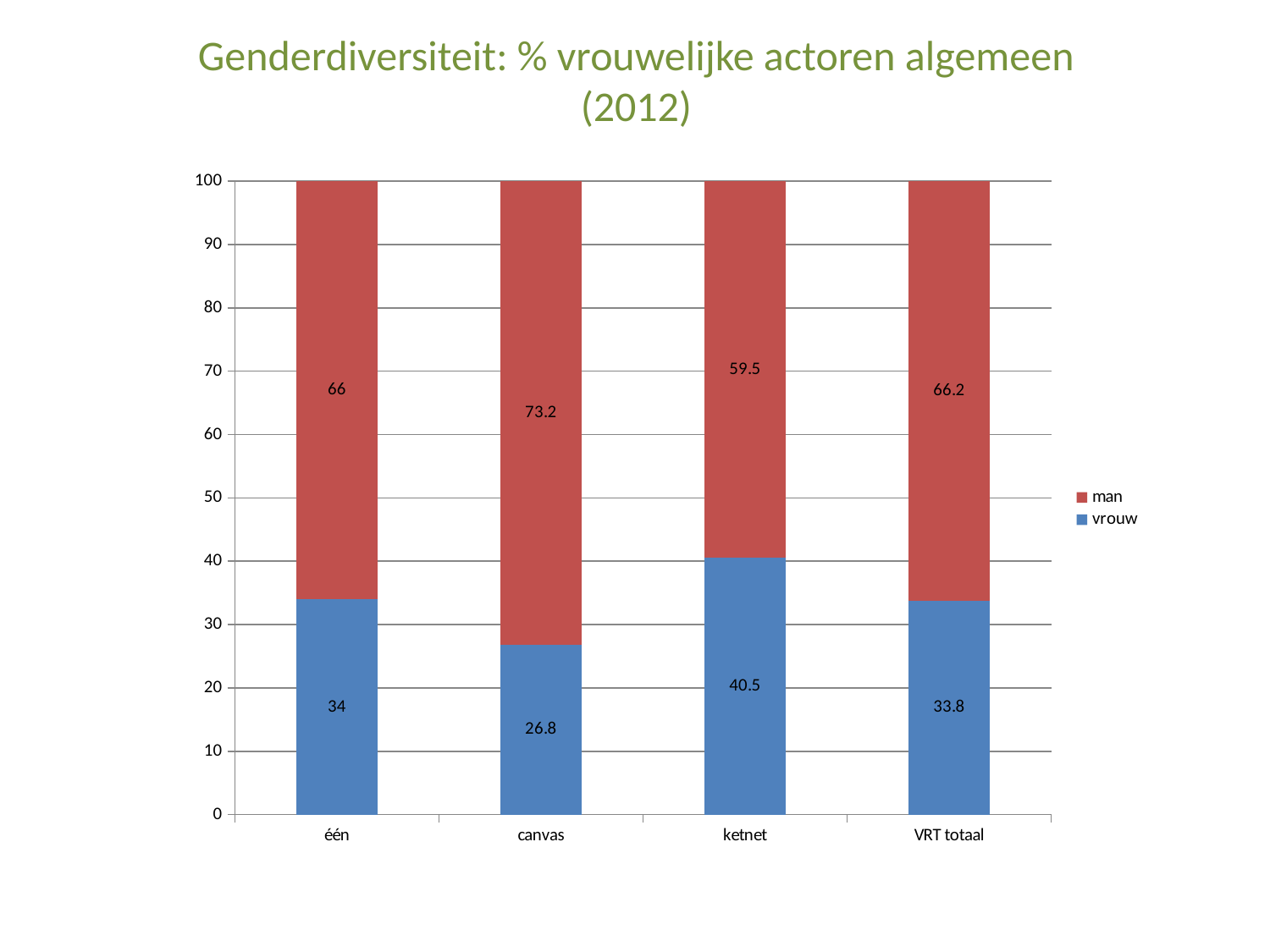
How many series does the legend list? 2 Which is larger: the vrouw value for één or the vrouw value for VRT totaal? één Which category has the lowest value for vrouw? canvas What is the difference between the man value for canvas and the man value for ketnet? 13.7 What is the value for man for canvas? 73.2 What is the value for vrouw for ketnet? 40.5 Which category has the highest value for vrouw? ketnet What is the value for vrouw for VRT totaal? 33.8 What is the title of the chart? Genderdiversiteit: % vrouwelijke actoren algemeen (2012) How many categories are shown on the x axis? 4 What kind of chart is shown on the slide? stacked bar chart What is the total of the stacked bar for één? 100